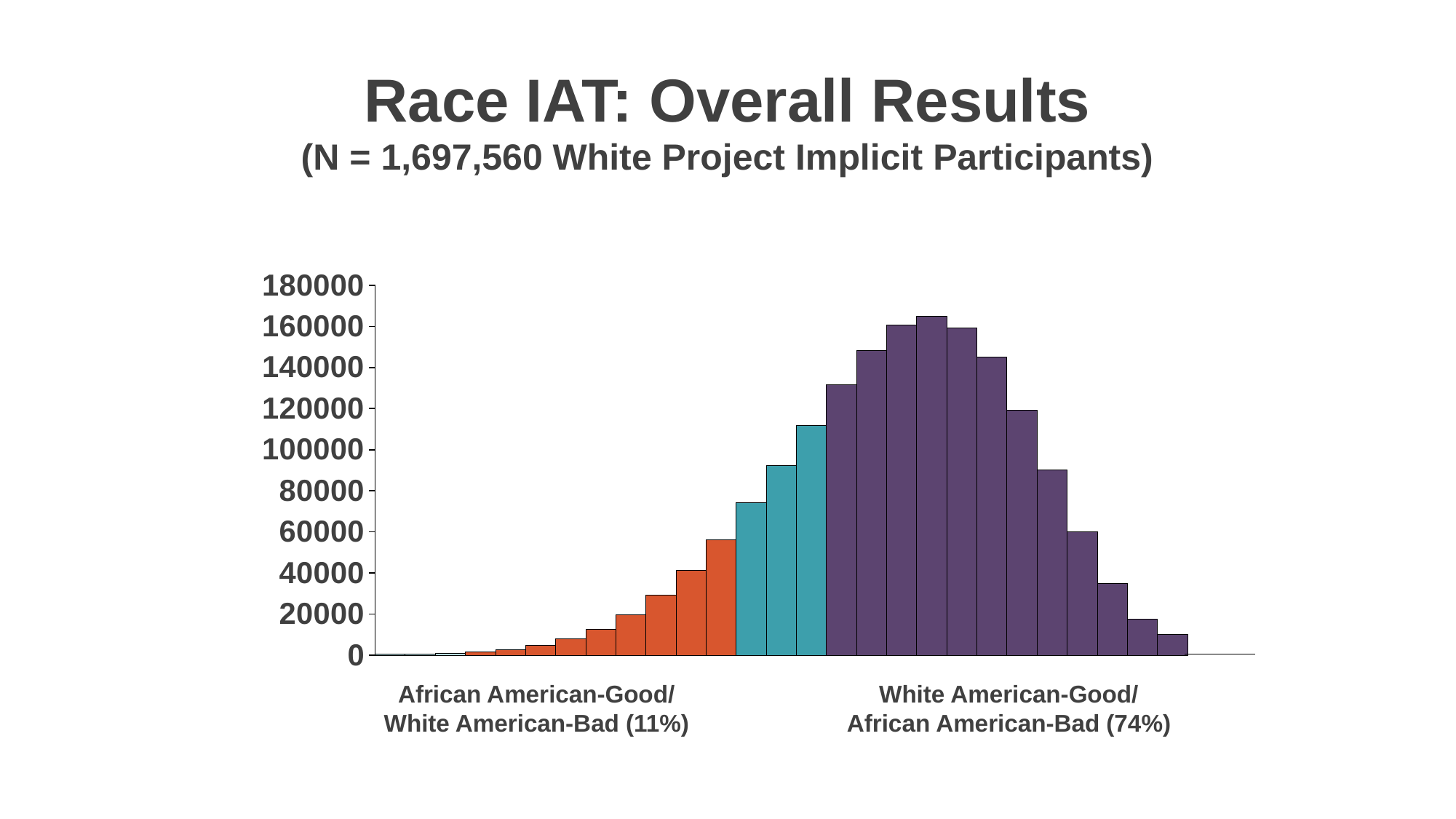
What is the title of the chart on the slide? Race IAT: Overall Results How many White Project Implicit participants (N) does the chart subtitle report? 1,697,560 Is the value of the tallest bar in the chart greater or less than 140000? greater What percentage of participants fall in the 'African American-Good/White American-Bad' group? 11% Is the value of the rightmost purple bar greater or less than 20000? less What percentage of participants fall in the 'White American-Good/African American-Bad' group? 74% Is the value of the tallest orange bar greater or less than 80000? less What is the difference in percentage points between the 'White American-Good/African American-Bad' group (74%) and the 'African American-Good/White American-Bad' group (11%)? 63 percentage points What kind of chart is shown on the slide? Bar chart Which group has the larger share of participants, 'African American-Good/White American-Bad' or 'White American-Good/African American-Bad'? White American-Good/African American-Bad What is the highest value shown on the vertical axis? 180000 Moving from the tallest bar toward the right edge of the chart, do the bar values rise or fall? fall